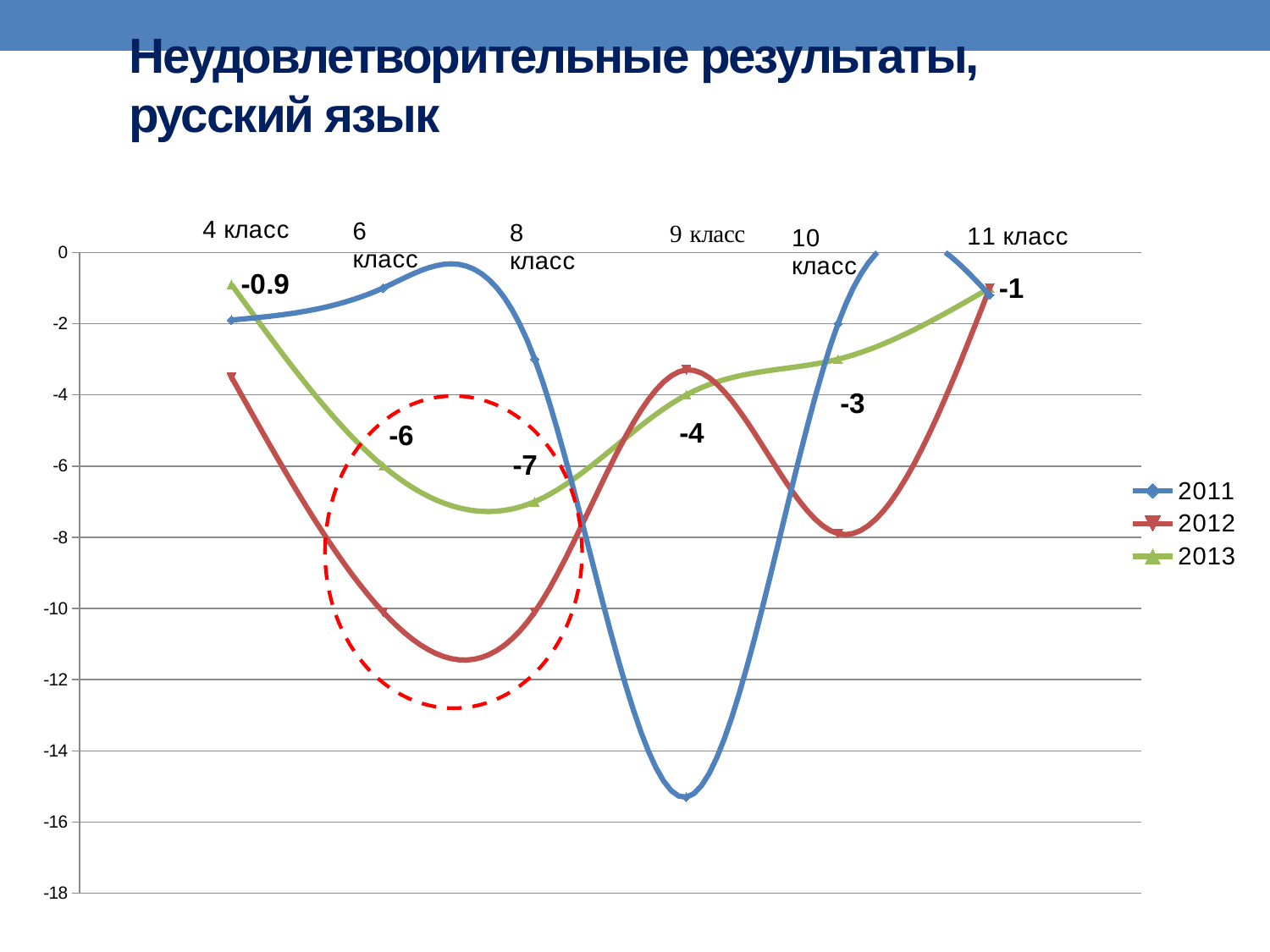
What is the value for 2013 at 10 класс? -3 How many class categories are plotted along the x axis? 6 How many series does the legend list? 3 Is the value for 2011 at 9 класс greater or less than -14? less What kind of chart is shown on the slide? line chart At 9 класс, which series has the higher value, 2011 or 2012? 2012 For the 2013 series, which class has the highest value? 4 класс What is the value for 2013 at 4 класс? -0.9 What is the difference between the 2013 values at 9 класс and 8 класс? 3 For the 2013 series, which class has the lowest value? 8 класс Does the 2013 series rise or fall from 8 класс to 11 класс? rises What is the value for 2013 at 8 класс? -7